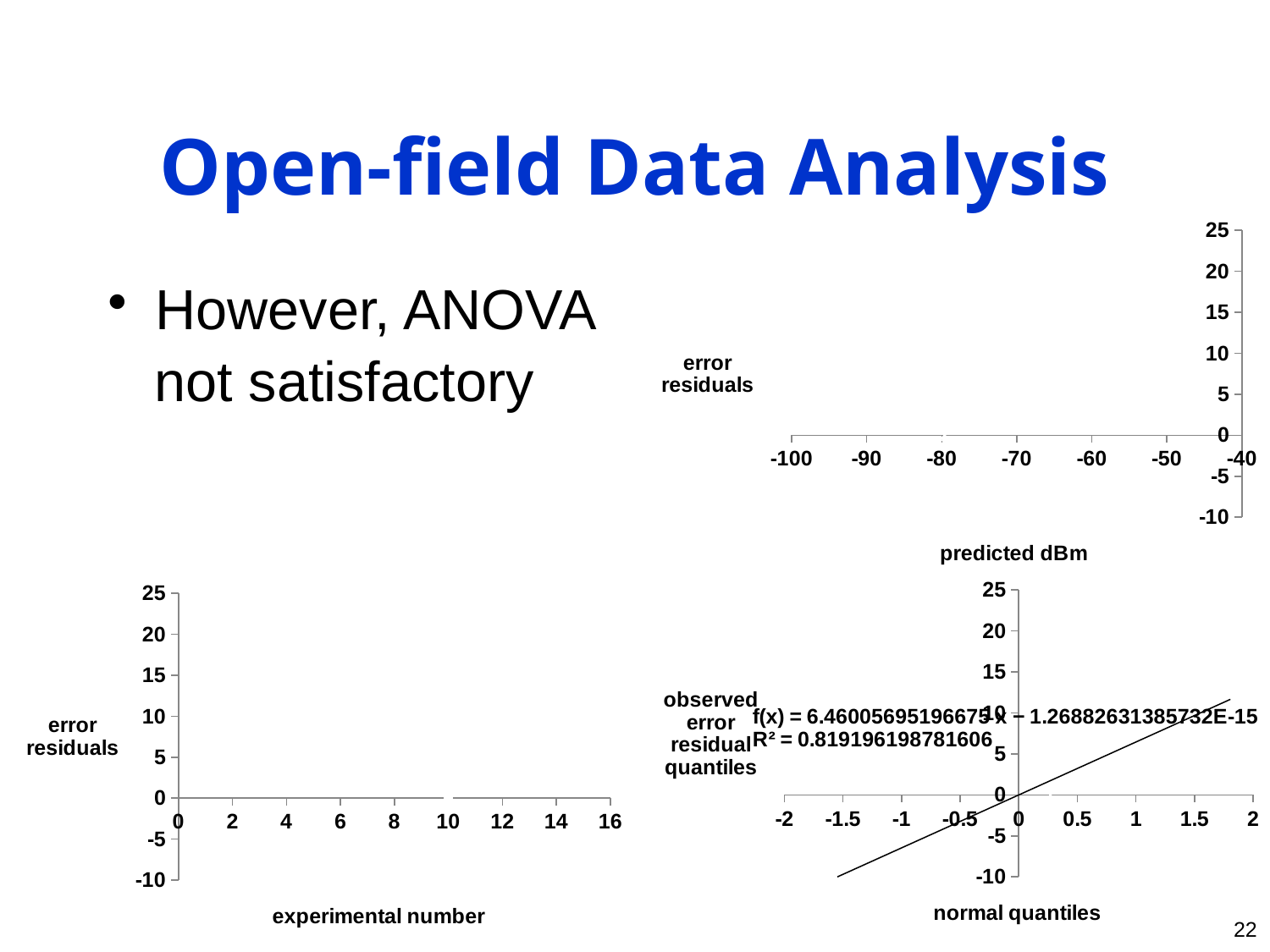
On the bottom-right chart, what is the R² value shown for the fitted line? 0.819196198781606 On the bottom-right chart, is the fitted line's value at a normal quantile of 1.5 greater or less than 5? greater On the bottom-right chart, what is the equation of the fitted line shown? f(x) = 6.46005695196675 x − 1.26882631385732E-15 On the bottom-right chart, does the fitted line rise or fall as the normal quantiles increase? rise On the bottom-right chart, is the fitted line's value at a normal quantile of -1.5 greater or less than -5? less What is the x-axis label of the top-right chart? predicted dBm What is the x-axis label of the bottom-left chart? experimental number